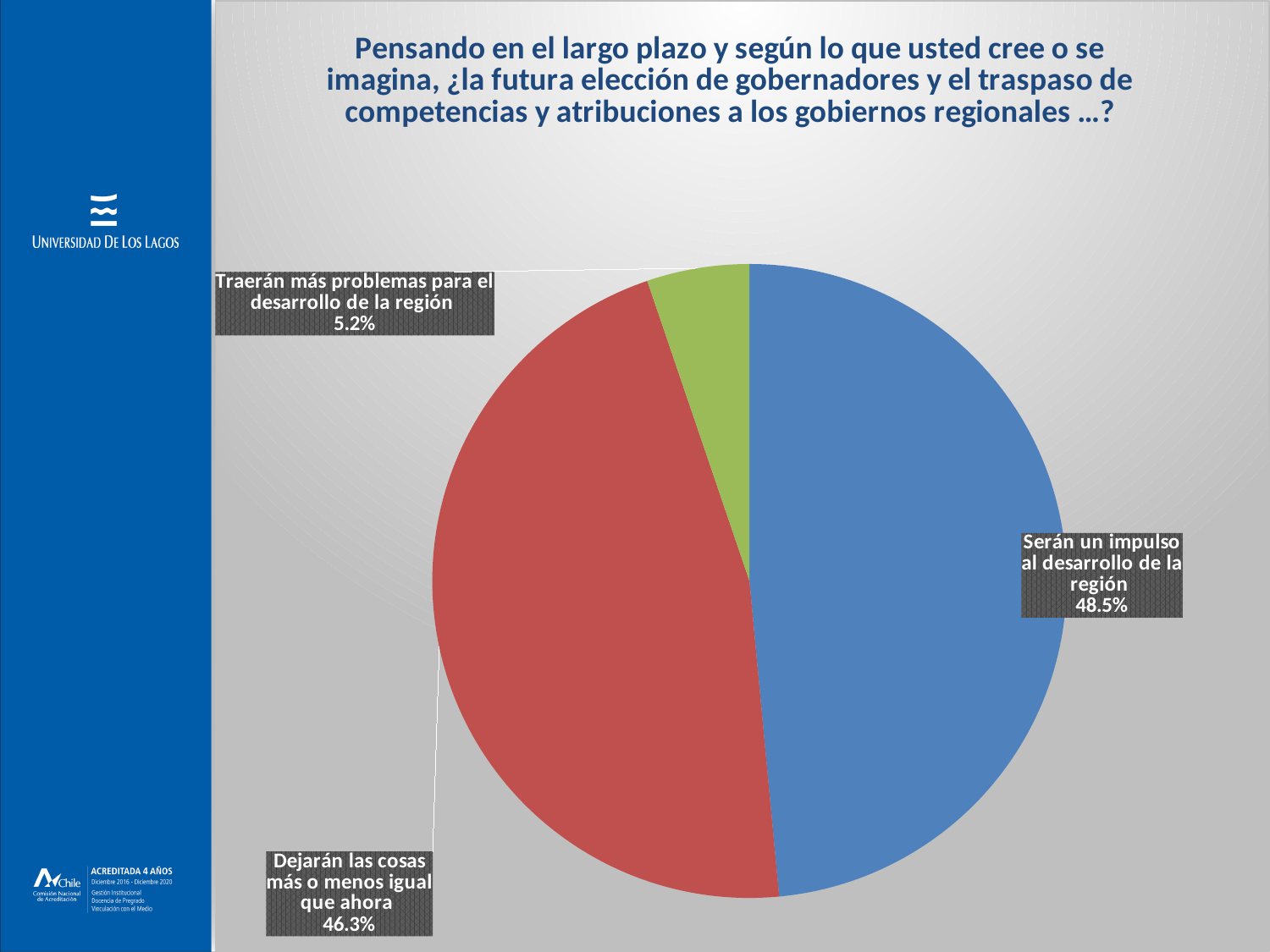
Which is larger: the share for 'Dejarán las cosas más o menos igual que ahora' or the share for 'Traerán más problemas para el desarrollo de la región'? Dejarán las cosas más o menos igual que ahora What colour is the slice for 'Serán un impulso al desarrollo de la región'? blue What percentage of respondents said the changes 'Dejarán las cosas más o menos igual que ahora'? 46.3% How many slices does the pie chart have? 3 Which response has the smallest share of the pie? Traerán más problemas para el desarrollo de la región What percentage of respondents said the changes 'Traerán más problemas para el desarrollo de la región'? 5.2% Which response has the largest share of the pie? Serán un impulso al desarrollo de la región What percentage of respondents said the changes 'Serán un impulso al desarrollo de la región'? 48.5% What kind of chart is shown on the slide? pie chart What is the difference in percentage points between 'Serán un impulso al desarrollo de la región' and 'Dejarán las cosas más o menos igual que ahora'? 2.2 percentage points What is the difference in percentage points between 'Dejarán las cosas más o menos igual que ahora' and 'Traerán más problemas para el desarrollo de la región'? 41.1 percentage points What colour is the slice for 'Traerán más problemas para el desarrollo de la región'? green